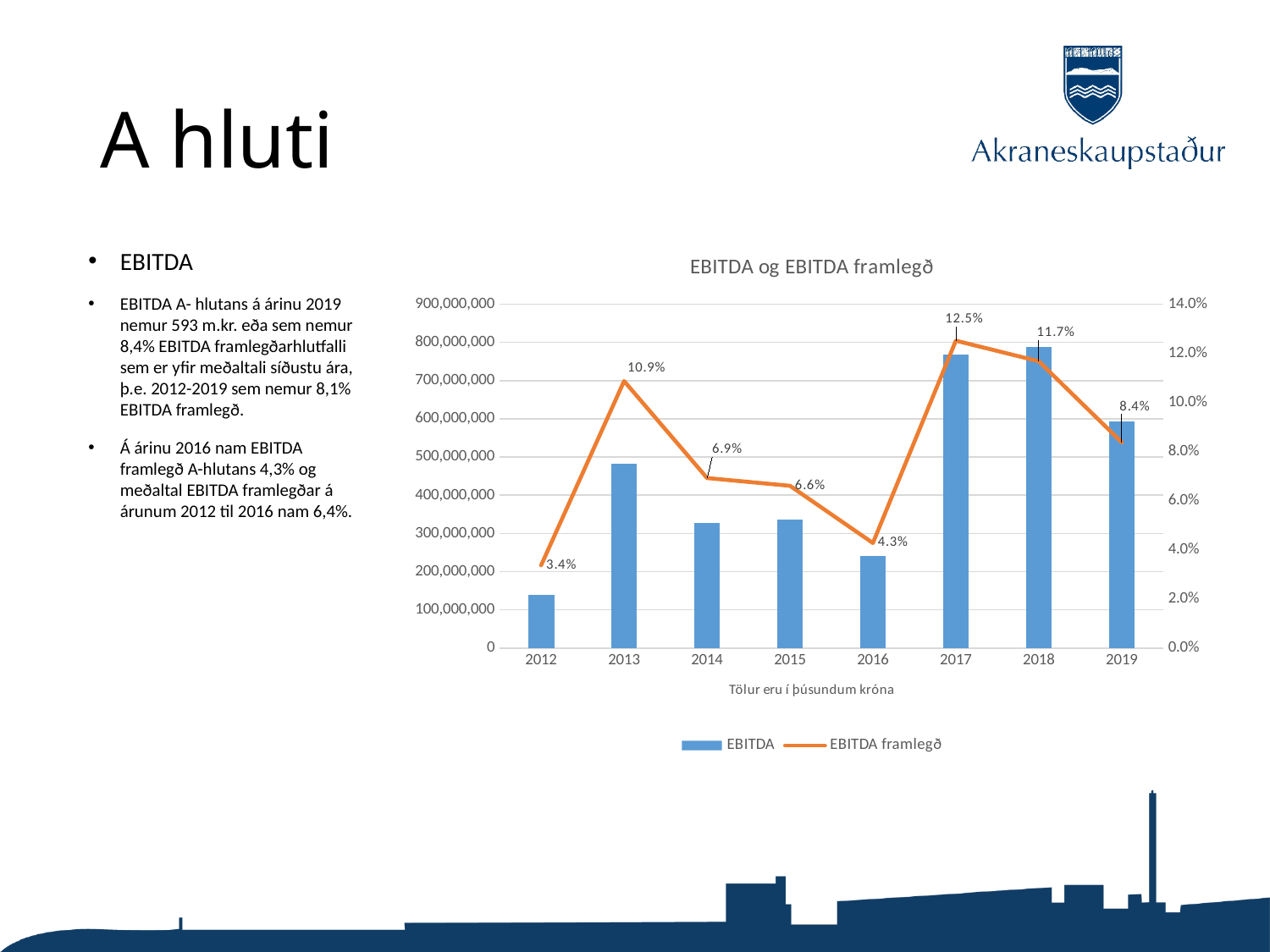
Is the EBITDA value for 2016 greater or less than 300,000,000? less Which year has the highest EBITDA framlegð? 2017 Which year has the lowest EBITDA bar? 2012 What is the EBITDA framlegð value for 2017? 12.5% What is the difference in EBITDA framlegð between 2017 and 2012? 9.1 percentage points How many years are shown on the x axis? 8 What is the EBITDA framlegð value for 2019? 8.4% Is the EBITDA value for 2017 greater or less than 700,000,000? greater What is the title of the chart? EBITDA og EBITDA framlegð Which is larger, the EBITDA framlegð for 2013 or for 2014? 2013 How many series does the legend list? 2 What is the EBITDA framlegð value for 2012? 3.4%